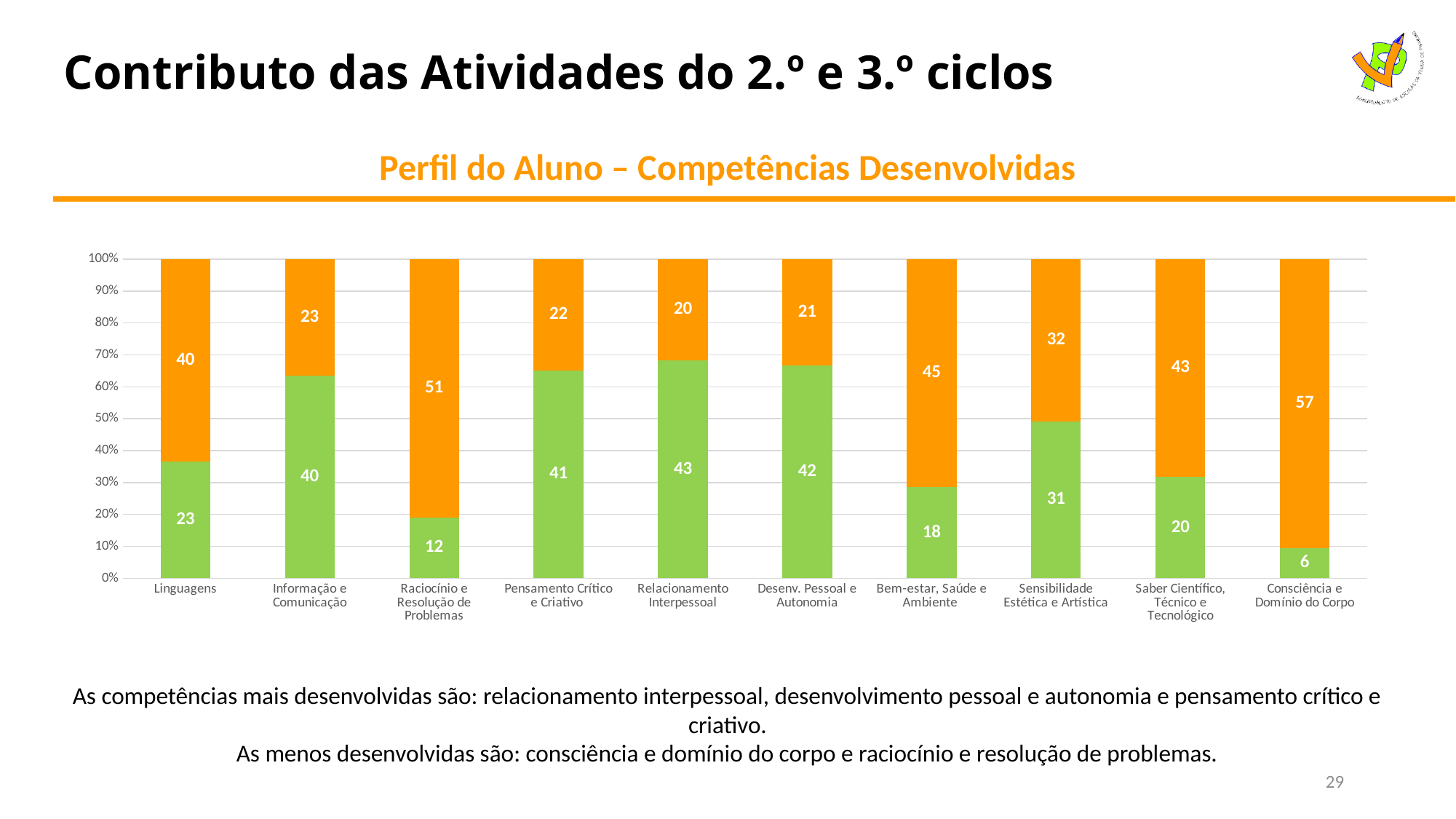
What is the sum of the green and orange segment values for Linguagens? 63 What is the difference between the orange and green segment values for Raciocínio e Resolução de Problemas? 39 What is the value of the orange segment for Consciência e Domínio do Corpo? 57 Which category has the largest green segment value? Relacionamento Interpessoal Which category has the smallest green segment value? Consciência e Domínio do Corpo Which category has the largest orange segment value? Consciência e Domínio do Corpo Which has a larger green segment value: Informação e Comunicação or Sensibilidade Estética e Artística? Informação e Comunicação How many categories are shown on the x axis? 10 What is the value of the orange segment for Raciocínio e Resolução de Problemas? 51 What kind of chart is shown on the slide? Stacked bar chart Is the top of the green segment for Linguagens greater or less than 30%? greater What is the value of the green segment for Linguagens? 23